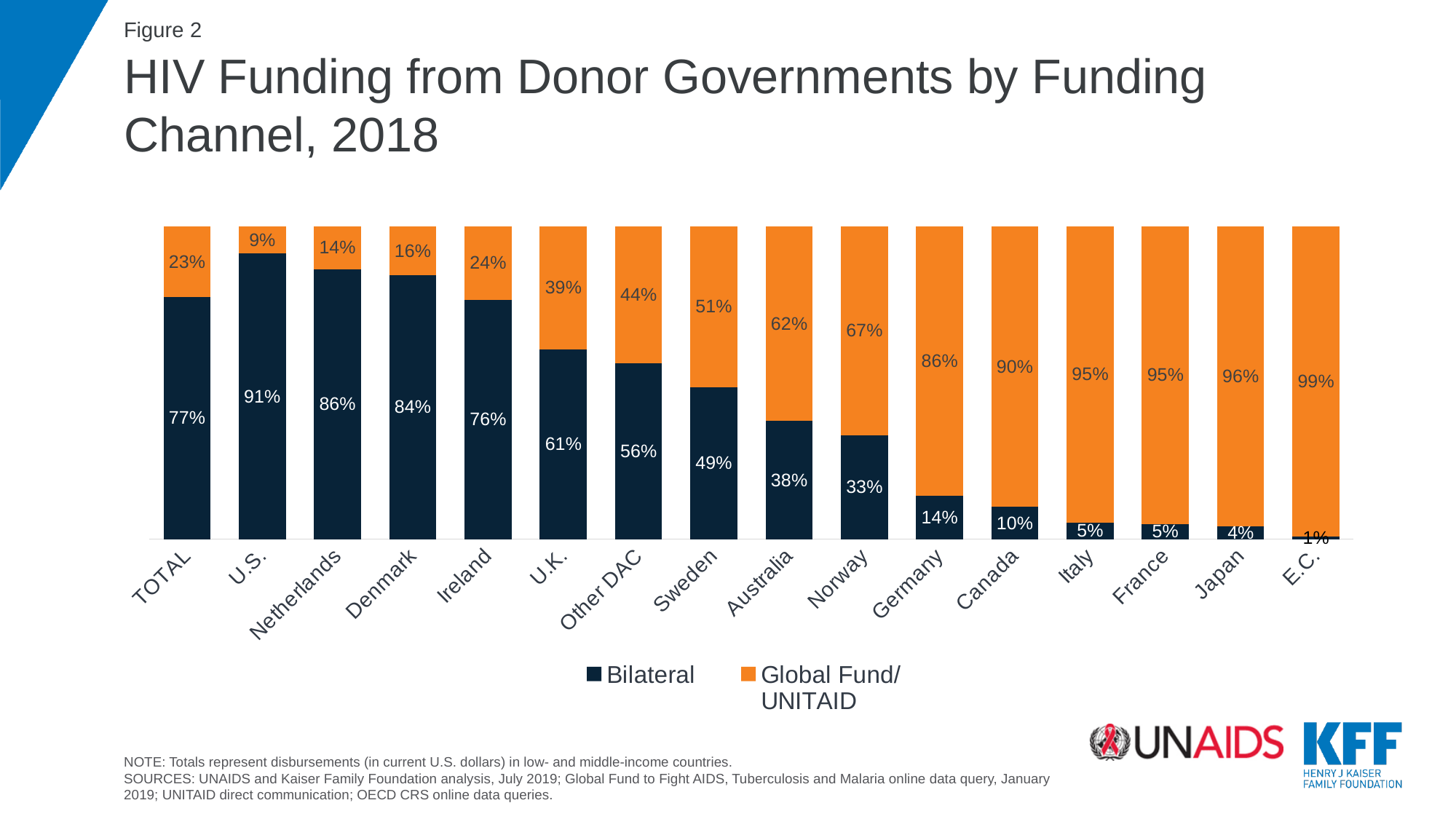
What is the Global Fund/UNITAID share for the E.C.? 99% What is the difference between the Bilateral shares of the Netherlands and Denmark? 2% Which series is shown in orange? Global Fund/UNITAID Which has a larger Global Fund/UNITAID share, Australia or Ireland? Australia What is the Global Fund/UNITAID share for Sweden? 51% How many categories are shown on the x axis? 16 How many series does the legend list? 2 What is the Bilateral share for the U.S.? 91% Which donor has the lowest Bilateral share? E.C. Which donor has the highest Bilateral share? U.S. What is the Bilateral share for Norway? 33% What kind of chart is shown on the slide? Stacked bar chart